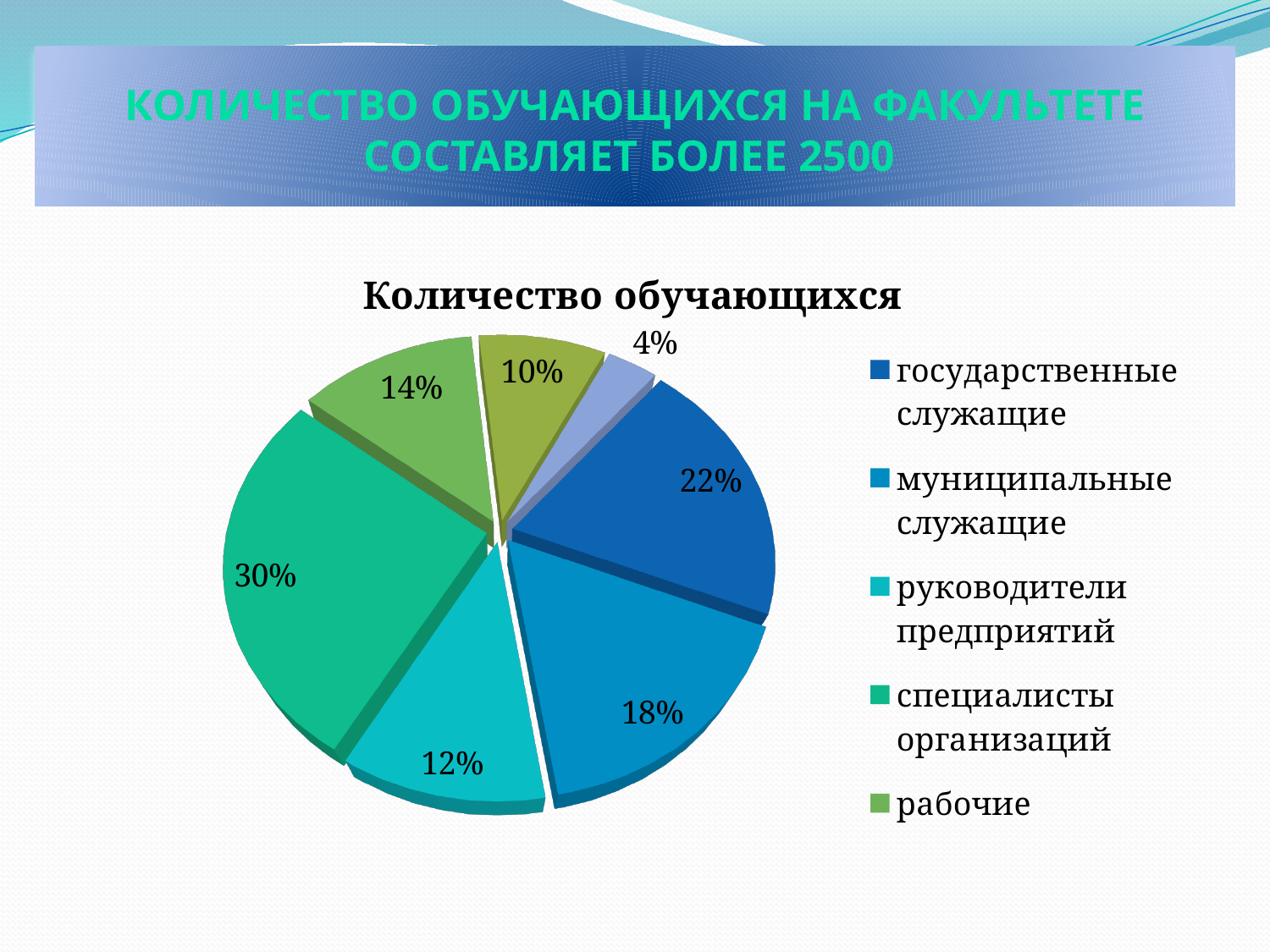
What share of the pie is labelled for государственные служащие? 22% What share of the pie is labelled for руководители предприятий? 12% What is the difference in percentage points between специалисты организаций and государственные служащие? 8 What type of chart is shown on the slide? pie chart What share of the pie is labelled for рабочие? 14% What share of the pie is labelled for муниципальные служащие? 18% How many slices does the pie chart have? 7 What is the smallest percentage labelled on the pie? 4% What share of the pie is labelled for специалисты организаций? 30% Which category has the largest slice of the pie? специалисты организаций Which is larger, the slice for муниципальные служащие or the slice for рабочие? муниципальные служащие What is the title of the chart? Количество обучающихся